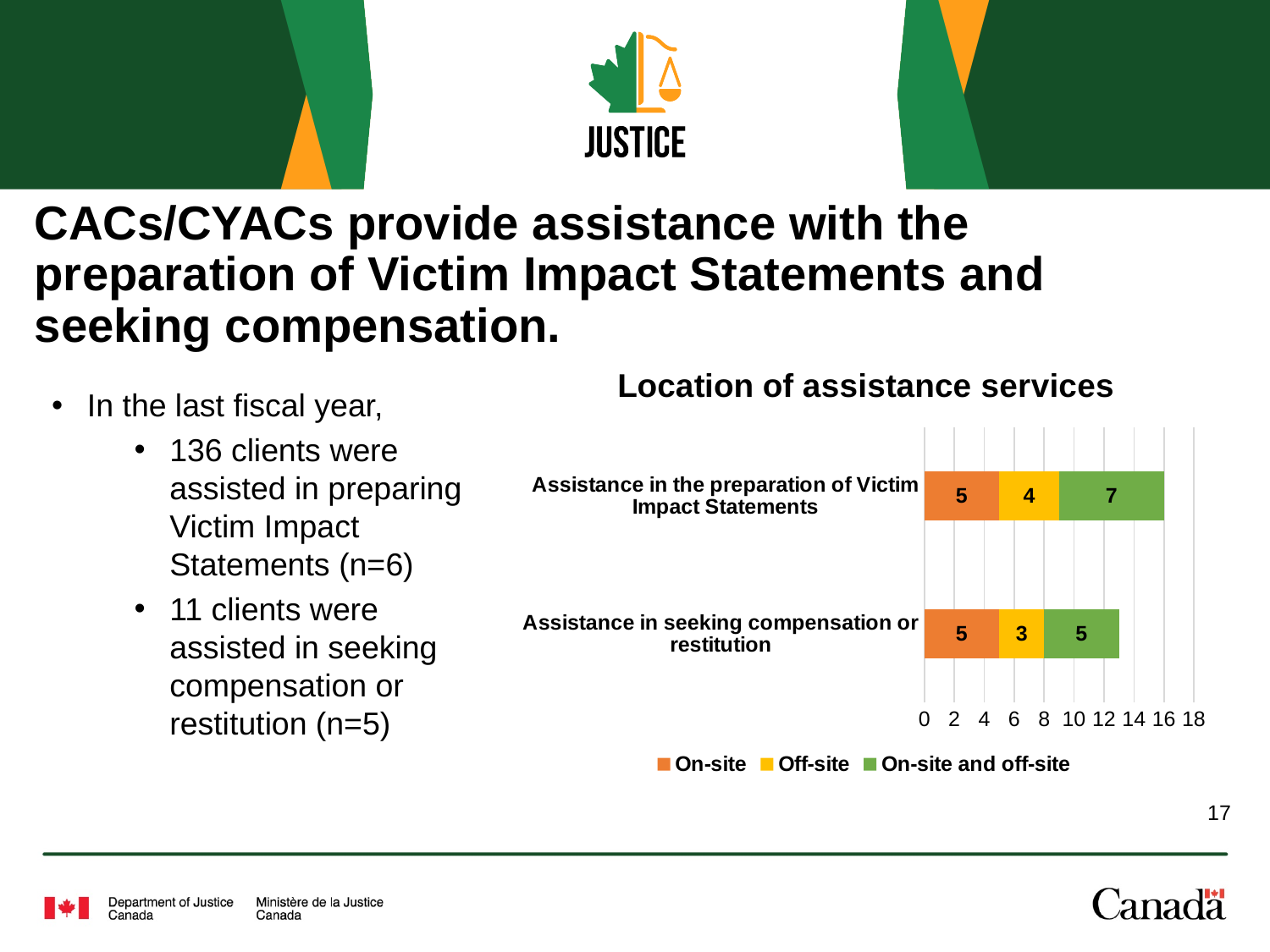
What is the Off-site value for Assistance in seeking compensation or restitution? 3 What is the difference between the Off-site values for the two categories? 1 How many series does the legend list? 3 What is the total of the stacked bar for Assistance in seeking compensation or restitution? 13 What is the On-site value for Assistance in the preparation of Victim Impact Statements? 5 What is the total of the stacked bar for Assistance in the preparation of Victim Impact Statements? 16 Which category has the larger On-site and off-site value? Assistance in the preparation of Victim Impact Statements What kind of chart is shown on the slide? Stacked bar chart What is the On-site and off-site value for Assistance in the preparation of Victim Impact Statements? 7 Which colour represents the Off-site series in the chart? Yellow How many categories are shown in the chart? 2 What is the title of the chart? Location of assistance services